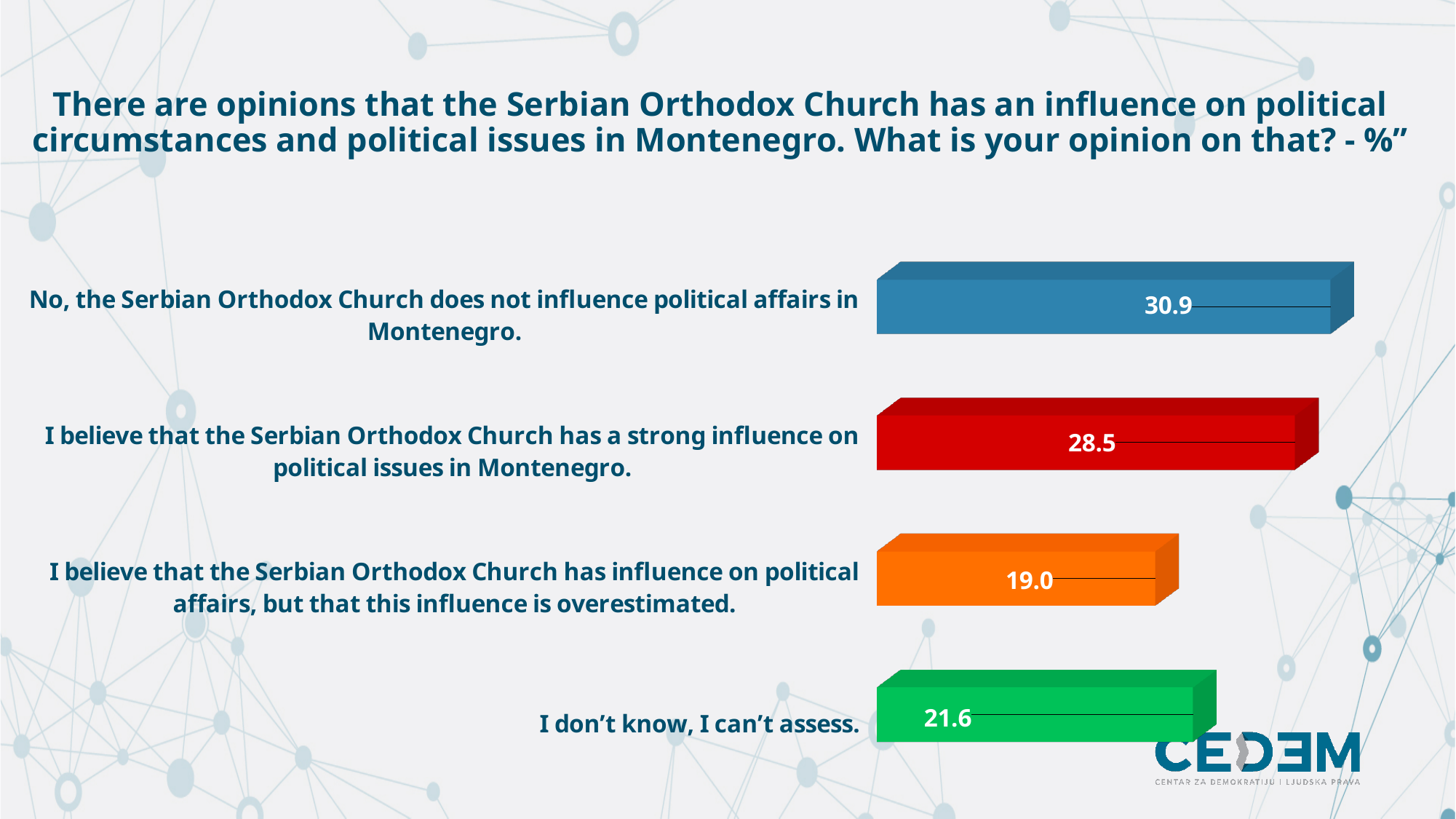
What value is shown for the response that the Serbian Orthodox Church has a strong influence on political issues in Montenegro? 28.5 What percentage of respondents said the Serbian Orthodox Church does not influence political affairs in Montenegro? 30.9 What value is shown for the response that the Church has influence but that this influence is overestimated? 19.0 What is the difference between the value for "does not influence political affairs" and the value for "has a strong influence"? 2.4 What kind of chart is shown on the slide? Bar chart What colour is the bar for "I believe that the Serbian Orthodox Church has a strong influence on political issues in Montenegro"? Red Which response has the lowest value? I believe that the Serbian Orthodox Church has influence on political affairs, but that this influence is overestimated. What value is shown for "I don't know, I can't assess"? 21.6 What is the difference between the value for "I don't know, I can't assess" and the value for "influence is overestimated"? 2.6 How many response categories are shown in the chart? 4 Which response has the highest value? No, the Serbian Orthodox Church does not influence political affairs in Montenegro. Which is larger: the value for "I don't know, I can't assess" or the value for "influence is overestimated"? I don't know, I can't assess.